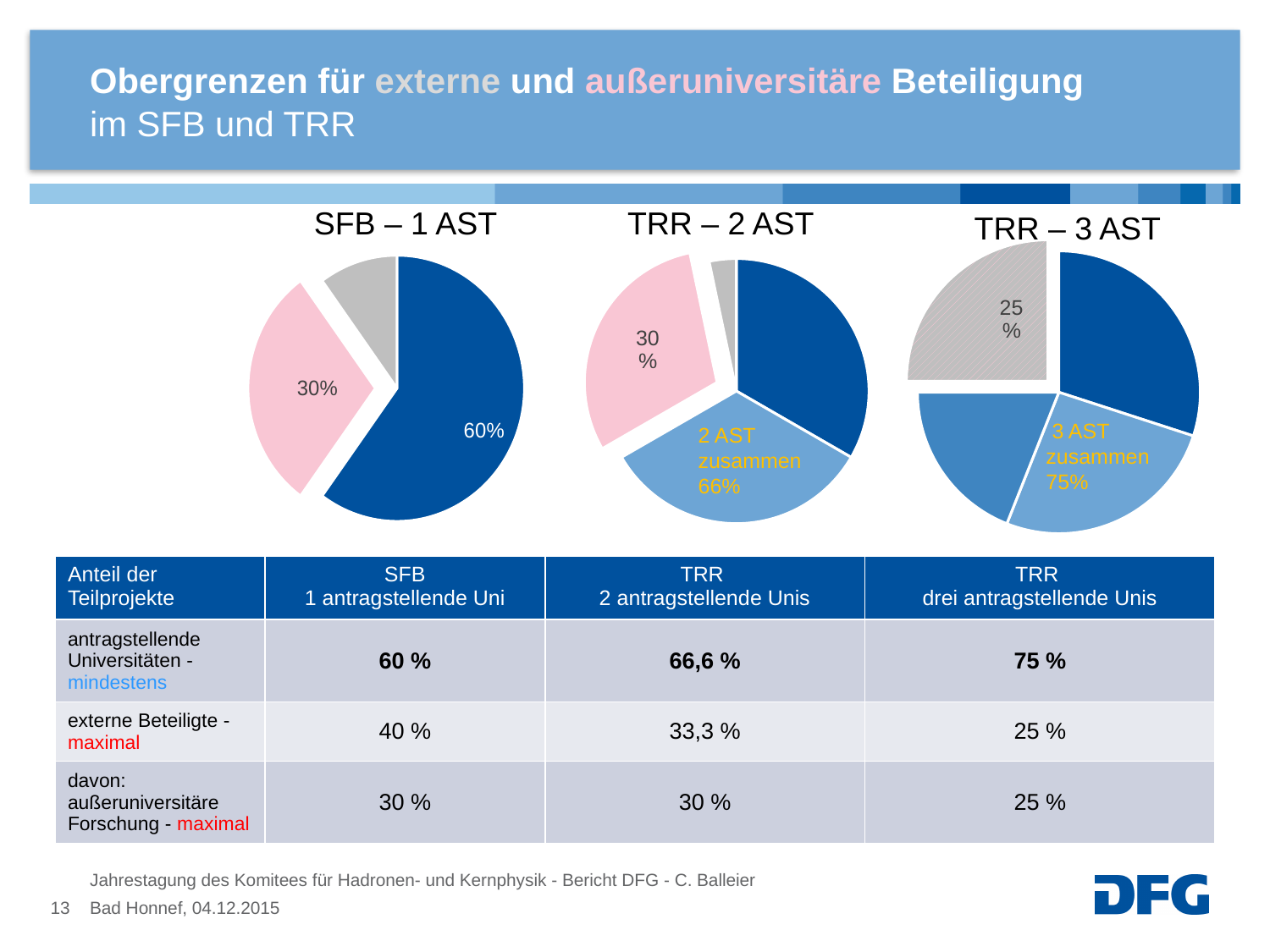
How many pie charts are shown on the slide? 3 In the "SFB – 1 AST" chart, what is the difference between the dark blue slice (60%) and the pink slice (30%)? 30% In the "SFB – 1 AST" chart, which slice is larger, the dark blue one or the pink one? the dark blue one (60%) In the "SFB – 1 AST" chart, what value is labelled on the dark blue slice? 60% What kind of chart is "SFB – 1 AST"? pie chart In the "TRR – 2 AST" chart, what value is labelled on the pink slice? 30% What is the title of the leftmost pie chart? SFB – 1 AST In the "TRR – 3 AST" chart, what combined share is given for "3 AST zusammen"? 75% In the "SFB – 1 AST" chart, what value is labelled on the pink slice? 30% In the "TRR – 3 AST" chart, what value is labelled on the grey hatched slice? 25% How many slices does the "SFB – 1 AST" pie chart have? 3 In the "TRR – 2 AST" chart, what combined share is given for "2 AST zusammen"? 66%